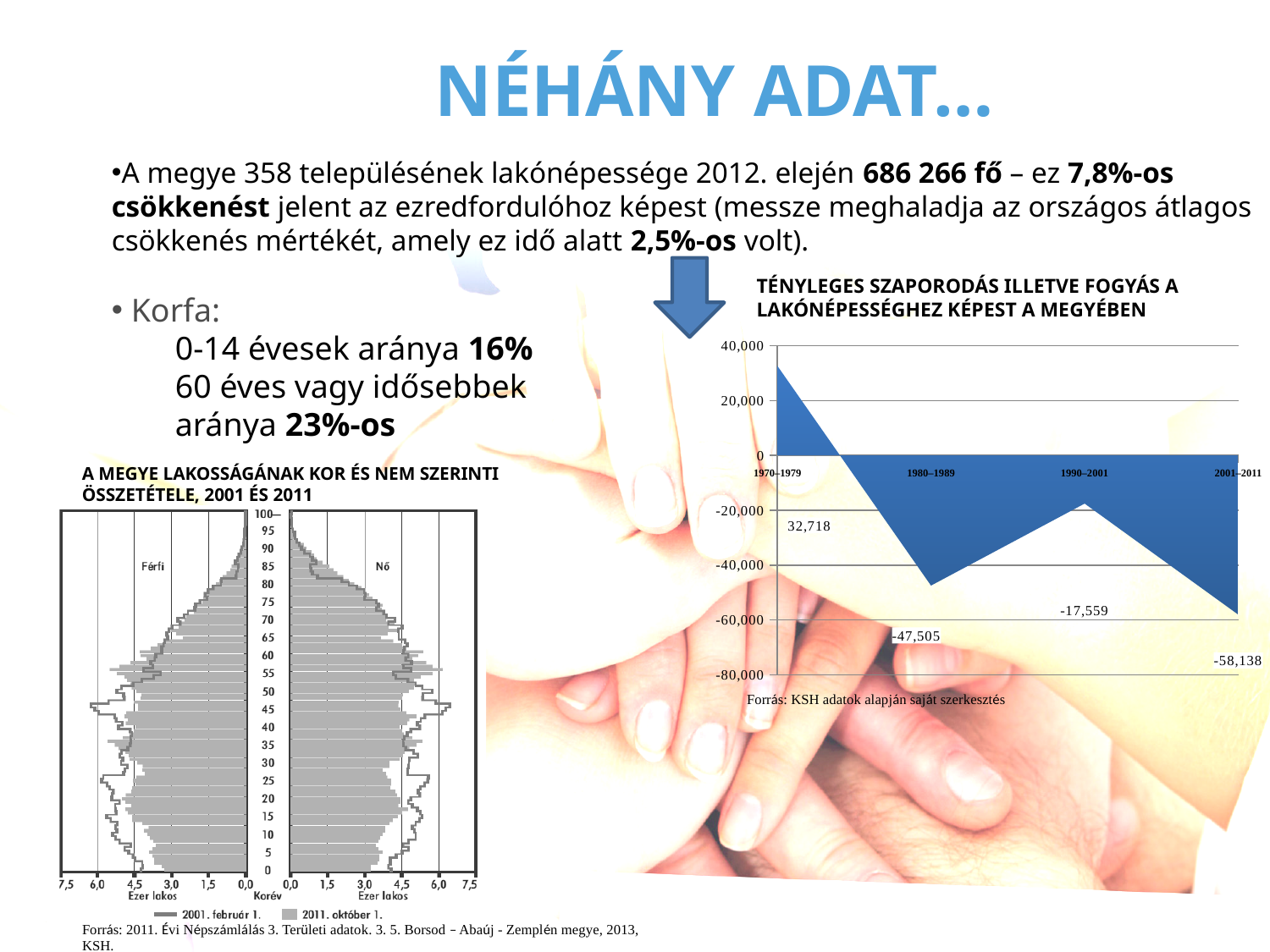
In the chart titled 'Tényleges szaporodás illetve fogyás a lakónépességhez képest a megyében', which is larger, the value for 1990–2001 or the value for 2001–2011? 1990–2001 In the chart titled 'Tényleges szaporodás illetve fogyás a lakónépességhez képest a megyében', what is the value for 1980–1989? -47,505 In the chart titled 'Tényleges szaporodás illetve fogyás a lakónépességhez képest a megyében', which period has the highest value? 1970–1979 What kind of chart is the one titled 'Tényleges szaporodás illetve fogyás a lakónépességhez képest a megyében'? Area chart In the chart titled 'Tényleges szaporodás illetve fogyás a lakónépességhez képest a megyében', what is the value for 2001–2011? -58,138 In the chart titled 'Tényleges szaporodás illetve fogyás a lakónépességhez képest a megyében', which period has the lowest value? 2001–2011 In the chart titled 'Tényleges szaporodás illetve fogyás a lakónépességhez képest a megyében', what is the difference between the values for 1980–1989 and 1990–2001? 29,946 In the chart titled 'Tényleges szaporodás illetve fogyás a lakónépességhez képest a megyében', is the value for 1970–1979 greater or less than 20,000? greater In the chart titled 'Tényleges szaporodás illetve fogyás a lakónépességhez képest a megyében', what is the value for 1970–1979? 32,718 In the chart titled 'Tényleges szaporodás illetve fogyás a lakónépességhez képest a megyében', how many periods are shown on the x axis? 4 In the chart titled 'Tényleges szaporodás illetve fogyás a lakónépességhez képest a megyében', what is the value for 1990–2001? -17,559 How many series does the legend of the chart titled 'A megye lakosságának kor és nem szerinti összetétele, 2001 és 2011' list? 2